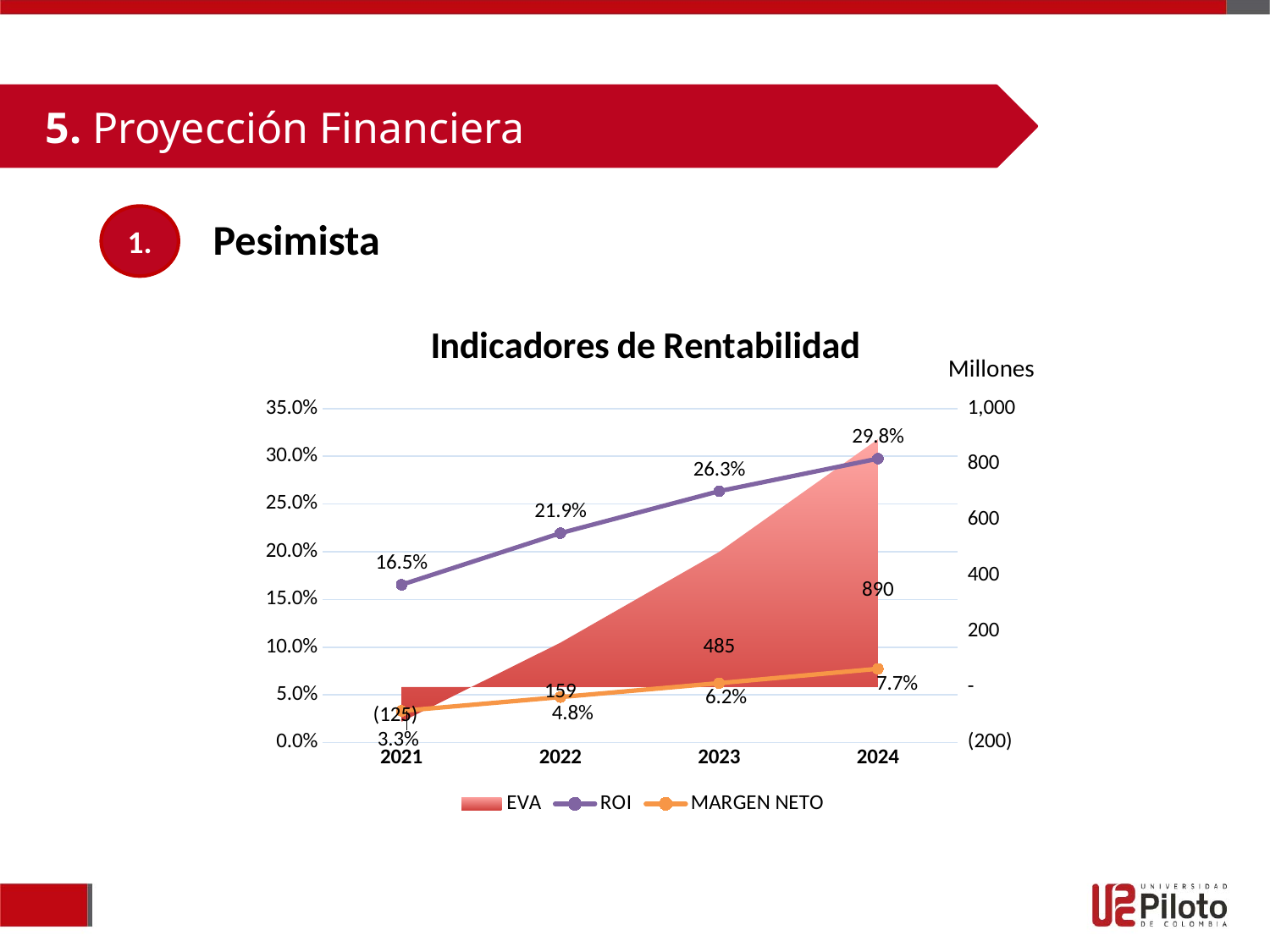
What is the difference between the ROI values for 2024 and 2021? 13.3% Does the ROI series rise or fall from 2021 to 2024? rise How many series does the legend list? 3 Which is larger, the ROI value for 2022 or the MARGEN NETO value for 2022? ROI What is the ROI value for 2023? 26.3% What is the EVA value for 2024? 890 In which year is MARGEN NETO lowest? 2021 What is the MARGEN NETO value for 2022? 4.8% What is the EVA value for 2021? (125) In which year is ROI highest? 2024 How many years are shown on the x axis? 4 What is the difference between the EVA values for 2024 and 2023? 405